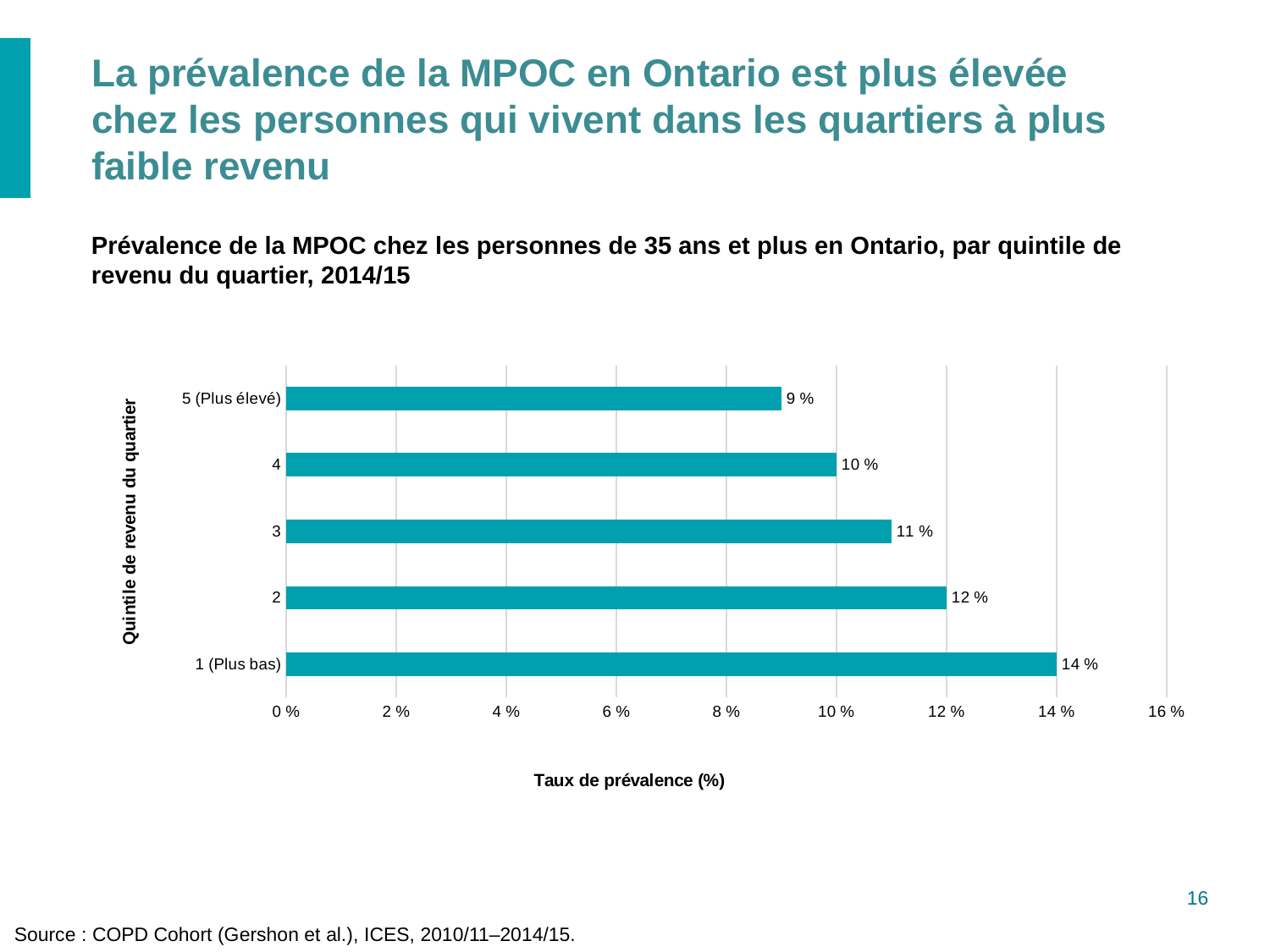
What is the prevalence rate for quintile 1 (Plus bas)? 14 % Does the prevalence rate rise or fall as the income quintile goes from 1 (Plus bas) to 5 (Plus élevé)? Fall How many income quintiles are shown in the chart? 5 What is the prevalence rate for quintile 3? 11 % Is the prevalence rate for quintile 2 greater or less than 10 %? greater What is the label of the horizontal axis of the chart? Taux de prévalence (%) Which income quintile has the highest prevalence rate? 1 (Plus bas) What kind of chart is shown on the slide? Bar chart What is the difference in prevalence rate between quintile 1 (Plus bas) and quintile 5 (Plus élevé)? 5 % What is the prevalence rate for quintile 5 (Plus élevé)? 9 % Which has a higher prevalence rate, quintile 2 or quintile 4? Quintile 2 Which income quintile has the lowest prevalence rate? 5 (Plus élevé)